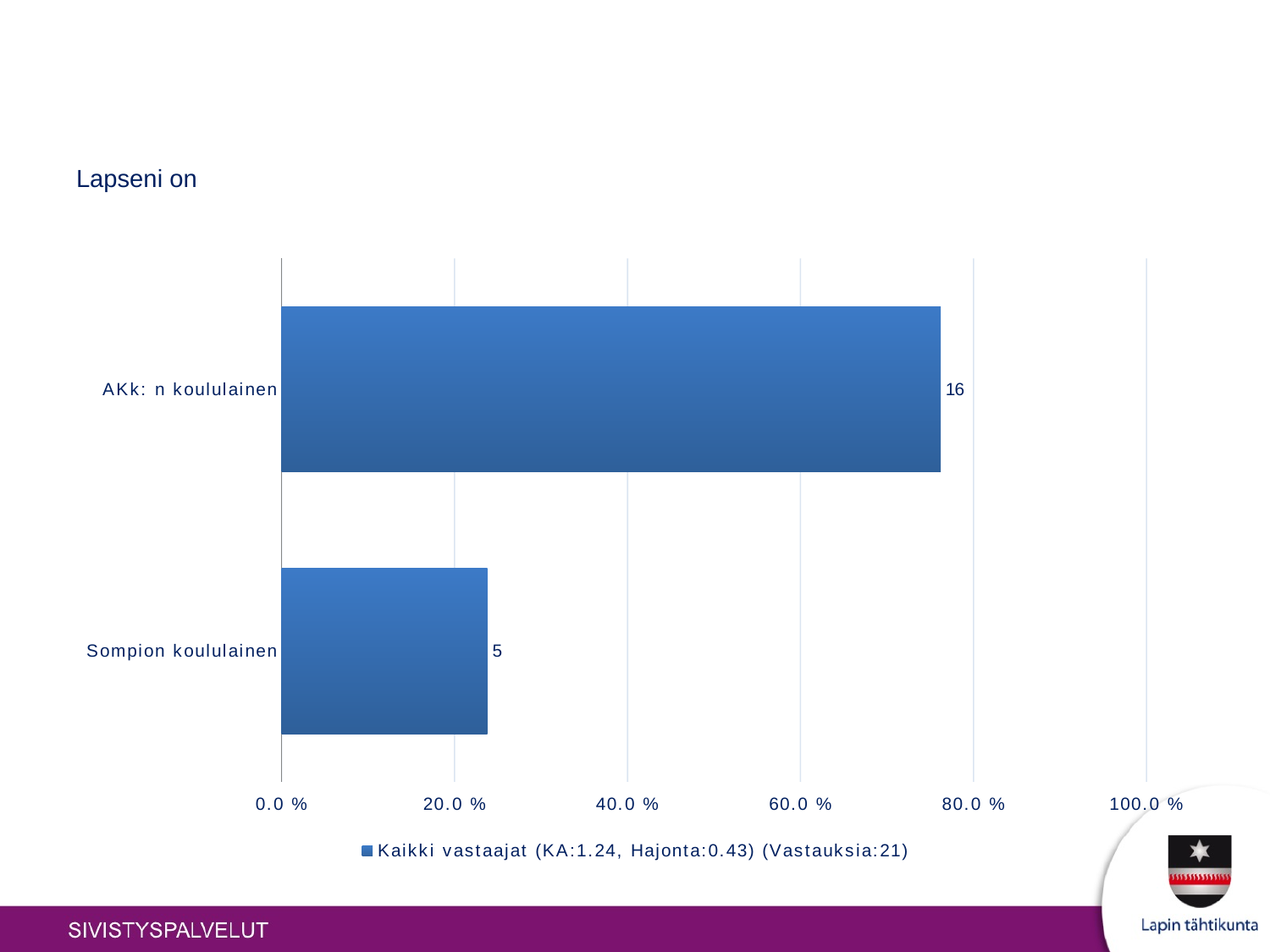
Is the bar for AKk: n koululainen greater or less than 60.0 % on the axis? greater What type of chart is shown on the slide? bar chart Is the bar for Sompion koululainen greater or less than 40.0 % on the axis? less What data label is shown on the bar for AKk: n koululainen? 16 What data label is shown on the bar for Sompion koululainen? 5 How many categories are shown in the chart? 2 What is the difference between the data labels for AKk: n koululainen and Sompion koululainen? 11 Which category has the highest value? AKk: n koululainen What is the legend entry shown below the chart? Kaikki vastaajat (KA:1.24, Hajonta:0.43) (Vastauksia:21) How many series does the legend list? 1 What is the title of the chart? Lapseni on Which category has the lowest value? Sompion koululainen